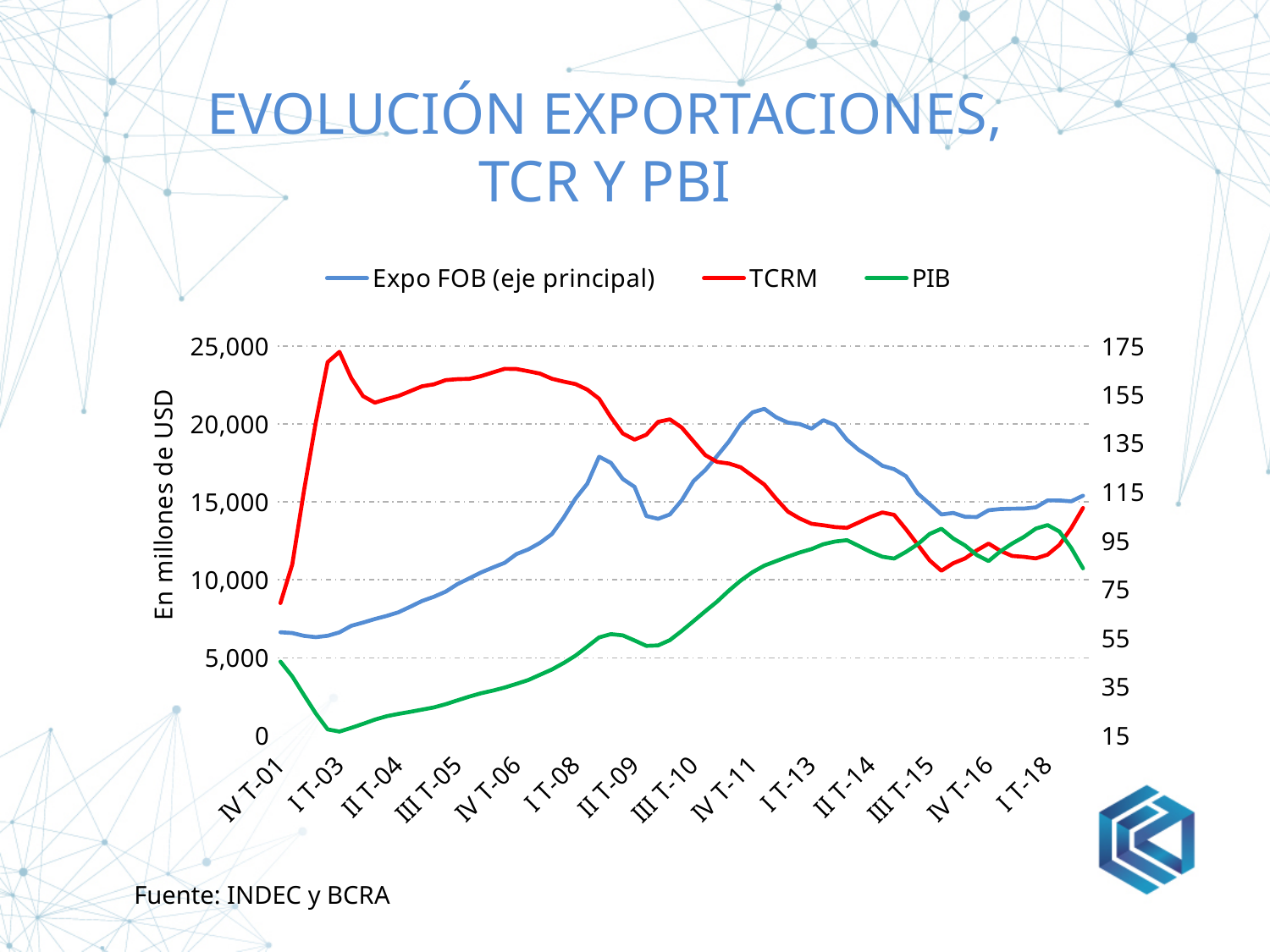
Is the value for TCRM at I T-03 greater or less than 155 on the right axis? greater Is the value for Expo FOB at I T-18 greater or less than 10,000? greater How many series does the legend list? 3 Is the value for PIB at I T-03 greater or less than 35 on the right axis? less At IV T-01, which series has the higher value on the right axis, TCRM or PIB? TCRM Does the Expo FOB line rise or fall from IV T-01 to IV T-11? rise What kind of chart is shown on the slide? line chart What is the label of the left vertical axis? En millones de USD Does the PIB line rise or fall from IV T-01 to I T-03? fall What is the title of the chart? EVOLUCIÓN EXPORTACIONES, TCR Y PBI